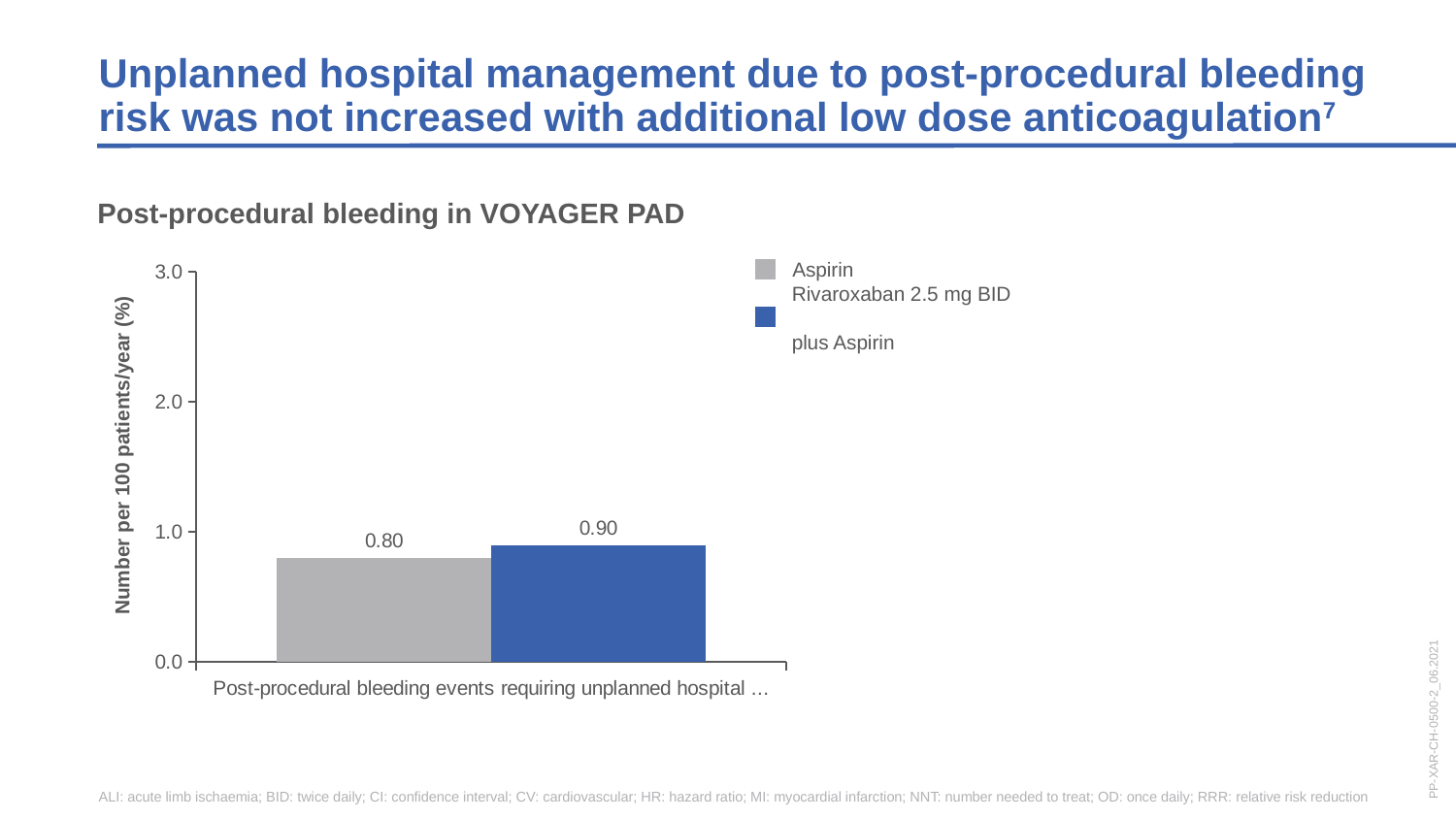
What is the value for Rivaroxaban 2.5 mg BID plus Aspirin in the chart? 0.90 Is the value for Aspirin greater or less than 1.0? less Which series has the lowest value in the chart? Aspirin How many series does the legend list? 2 What is the value for Aspirin in the Post-procedural bleeding in VOYAGER PAD chart? 0.80 What colour is the bar for Aspirin? Grey What is the difference between the Rivaroxaban 2.5 mg BID plus Aspirin value and the Aspirin value? 0.10 Is the value for Rivaroxaban 2.5 mg BID plus Aspirin greater or less than 2.0? less What is the y-axis label of the chart? Number per 100 patients/year (%) Which series has the higher value, Aspirin or Rivaroxaban 2.5 mg BID plus Aspirin? Rivaroxaban 2.5 mg BID plus Aspirin What kind of chart is shown on the slide? Bar chart What is the maximum value shown on the y-axis? 3.0